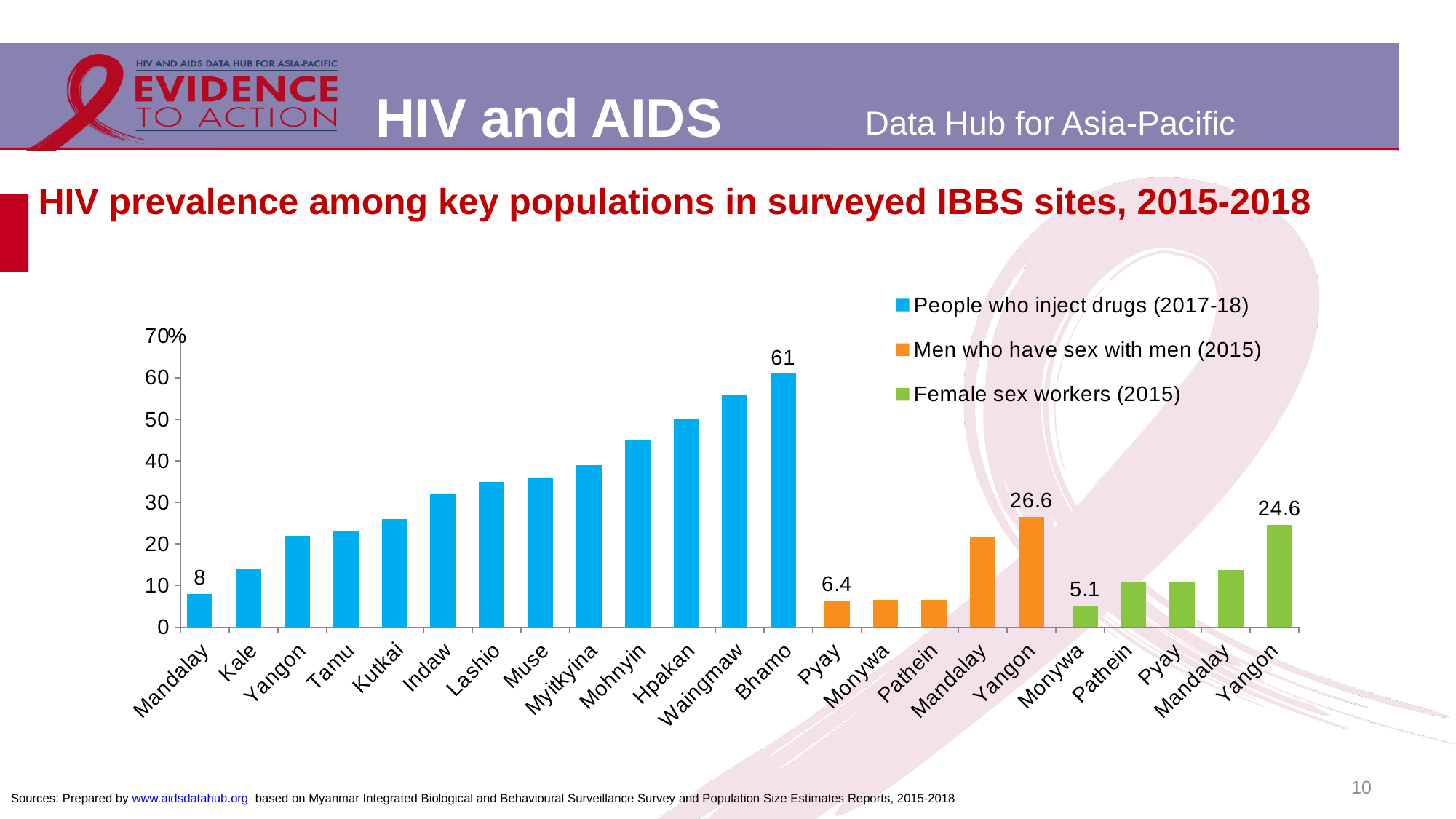
Which site has the lowest HIV prevalence among female sex workers? Monywa What kind of chart is shown on the slide? bar chart Which is larger: the value for Bhamo among people who inject drugs or the value for Yangon among men who have sex with men? Bhamo What is the HIV prevalence value shown for Bhamo among people who inject drugs? 61 What is the difference between the Yangon value for men who have sex with men and the Yangon value for female sex workers? 2 What is the HIV prevalence value shown for Pyay among men who have sex with men? 6.4 Is the value for Waingmaw among people who inject drugs greater or less than 50? greater Which site has the highest HIV prevalence on the chart? Bhamo What is the HIV prevalence value shown for Yangon among men who have sex with men? 26.6 How many sites are shown for people who inject drugs? 13 How many series does the legend list? 3 What is the HIV prevalence value shown for Yangon among female sex workers? 24.6